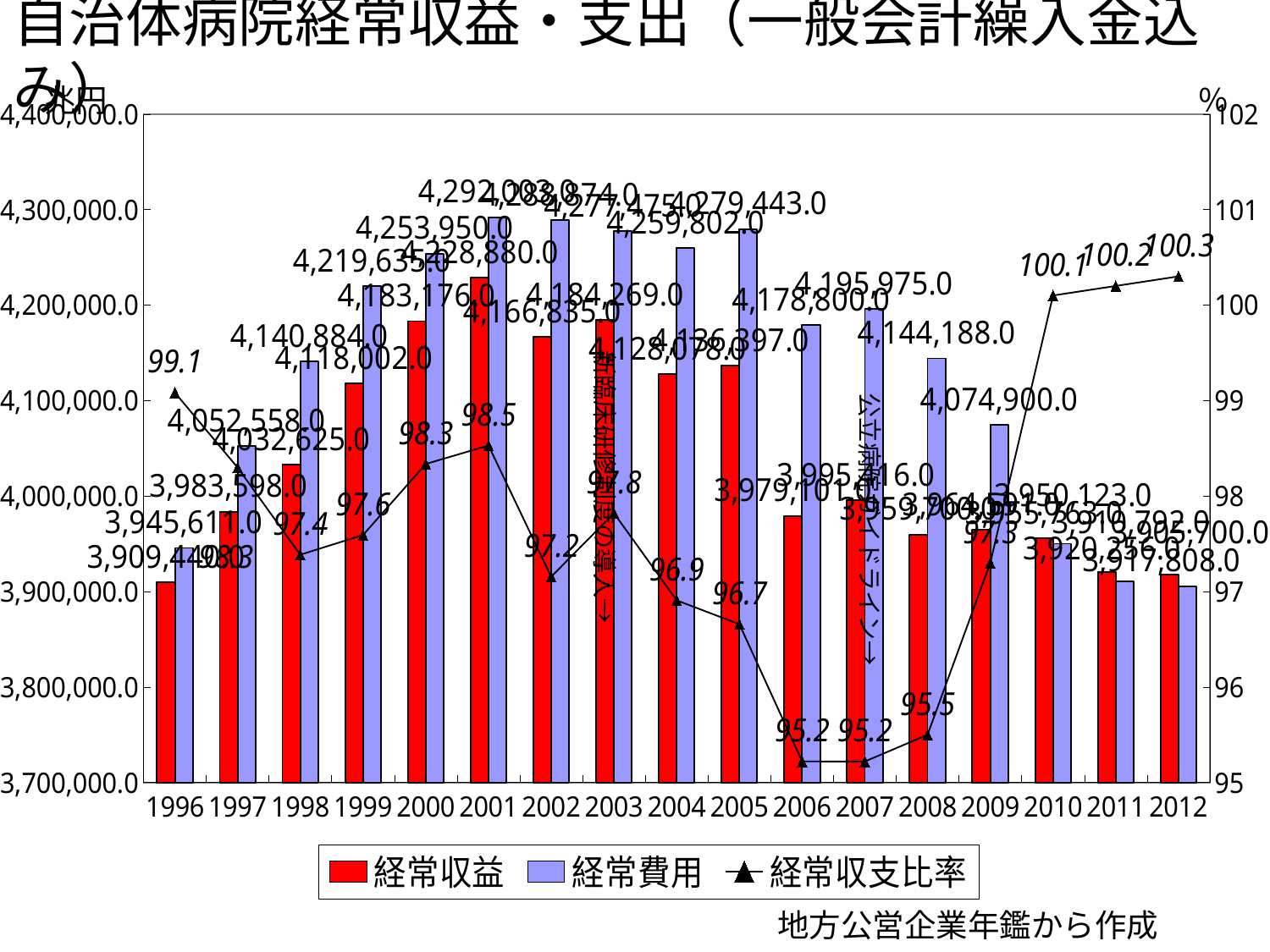
What is the 経常費用 value for 2009? 4,074,900.0 What is the 経常収支比率 value for 2012? 100.3 What kind of chart is shown on the slide? A combined bar and line chart In which year is the 経常収支比率 highest? 2012 Does the 経常収支比率 line rise or fall from 2006 to 2012? rise Is the 経常費用 value for 2012 greater or less than 4,000,000.0? less What is the difference between 経常費用 and 経常収益 in 2000? 70,774.0 In which year is the 経常収益 bar highest? 2001 How many series does the legend list? 3 What is the 経常収益 value for 1999? 4,118,002.0 Which is larger in 2006, 経常収益 or 経常費用? 経常費用 How many years are shown on the x axis? 17